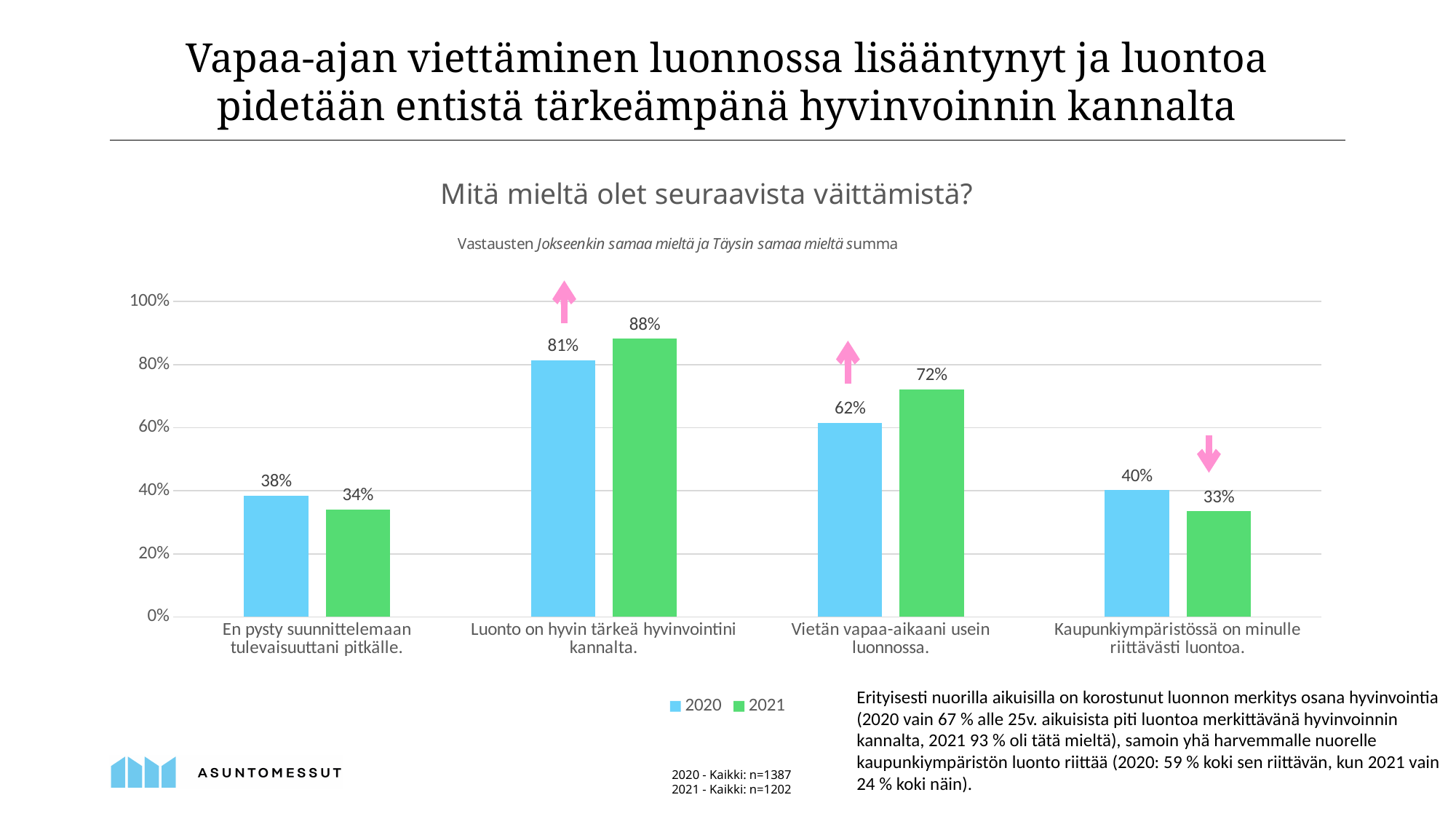
Is the 2020 value for "Luonto on hyvin tärkeä hyvinvointini kannalta." greater or less than 80%? greater What is the 2021 value for "Kaupunkiympäristössä on minulle riittävästi luontoa."? 33% How many series does the legend list? 2 What kind of chart is shown on the slide? Bar chart What is the difference between the 2020 and 2021 values for "En pysty suunnittelemaan tulevaisuuttani pitkälle."? 4% What is the 2021 value for "Luonto on hyvin tärkeä hyvinvointini kannalta."? 88% Which category has the lowest 2021 value? Kaupunkiympäristössä on minulle riittävästi luontoa. Which category has the highest 2020 value? Luonto on hyvin tärkeä hyvinvointini kannalta. What is the difference between the 2021 and 2020 values for "Vietän vapaa-aikaani usein luonnossa."? 10% How many categories are shown on the x axis? 4 What is the 2020 value for "Vietän vapaa-aikaani usein luonnossa."? 62% For "Kaupunkiympäristössä on minulle riittävästi luontoa.", which year has the larger value, 2020 or 2021? 2020